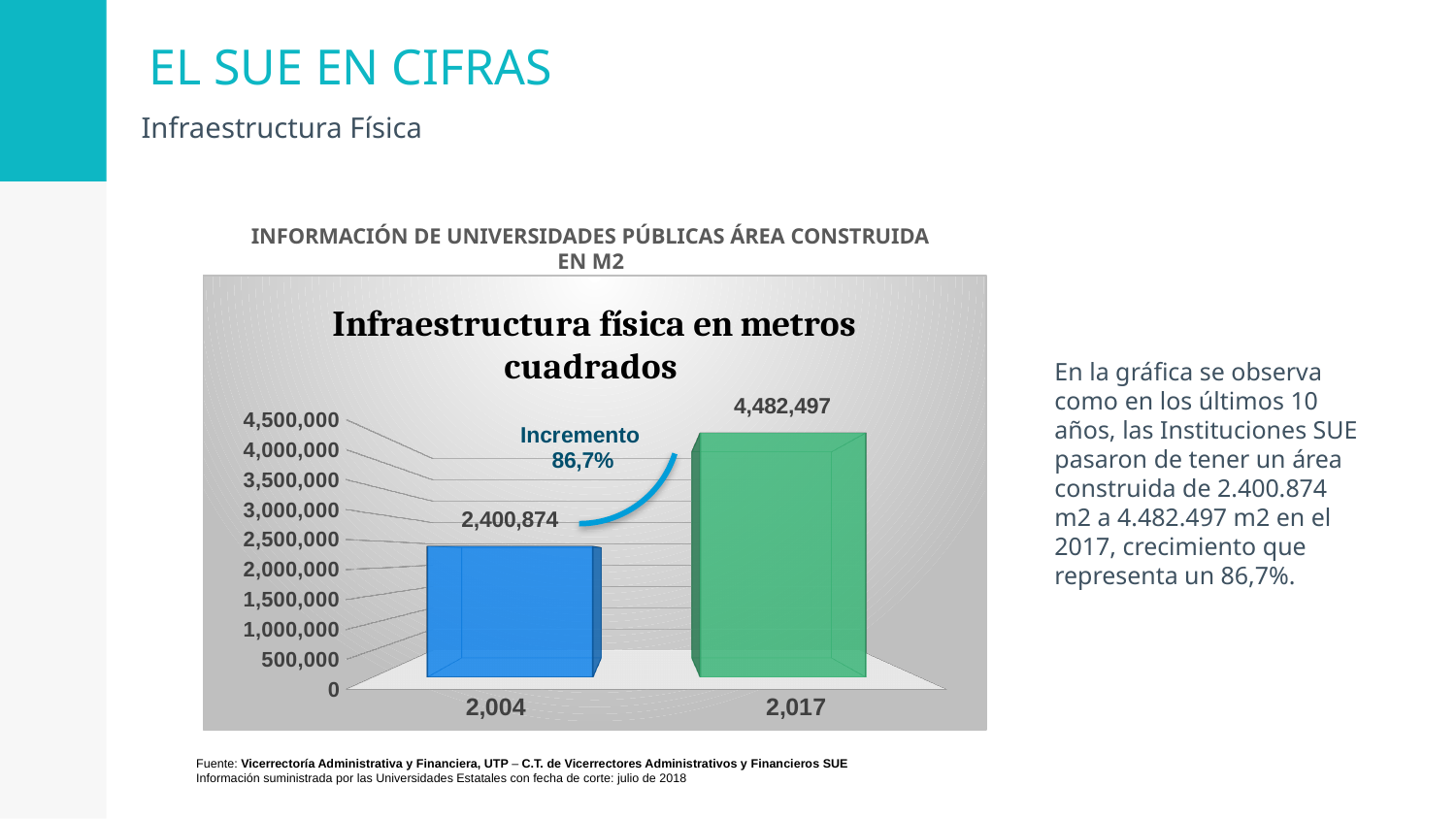
Is the value for 2,017 greater or less than 4,000,000? greater Is the value for 2,004 greater or less than 2,000,000? greater Which is larger, the value for 2,004 or the value for 2,017? 2,017 What is the difference between the values for 2,017 and 2,004? 2,081,623 Which category has the lowest value? 2,004 What is the value shown for 2,004? 2,400,874 Do the values rise or fall from 2,004 to 2,017? rise How many bars are plotted in the chart? 2 What percentage increase is annotated on the chart? 86,7% What kind of chart is shown? bar chart What is the value shown for 2,017? 4,482,497 Which category has the highest value? 2,017